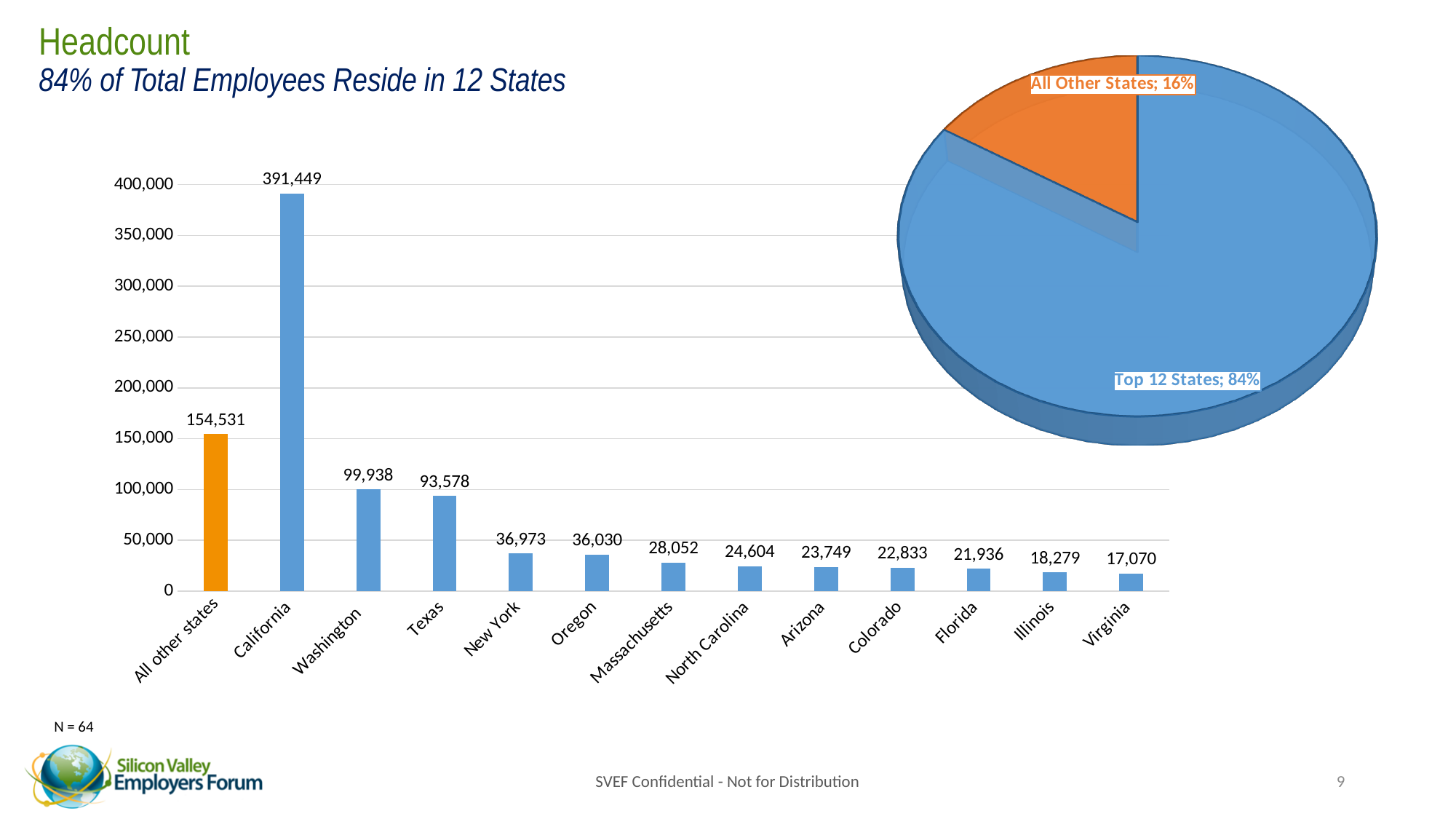
In the bar chart, which category has the lowest value? Virginia In the bar chart, what is the difference between Washington and Texas? 6,360 In the bar chart, what is the value for All other states? 154,531 In the bar chart, which bar is coloured orange rather than blue? All other states In the bar chart, what is the headcount for California? 391,449 In the bar chart, which is larger, New York or Oregon? New York In the bar chart, what is the headcount for Texas? 93,578 In the bar chart, how many categories are shown on the x axis? 13 In the pie chart, what share do the Top 12 States represent? 84% What kind of chart is on the left side of the slide? Bar chart In the bar chart, which state has the highest headcount? California In the pie chart, what share do All Other States represent? 16%